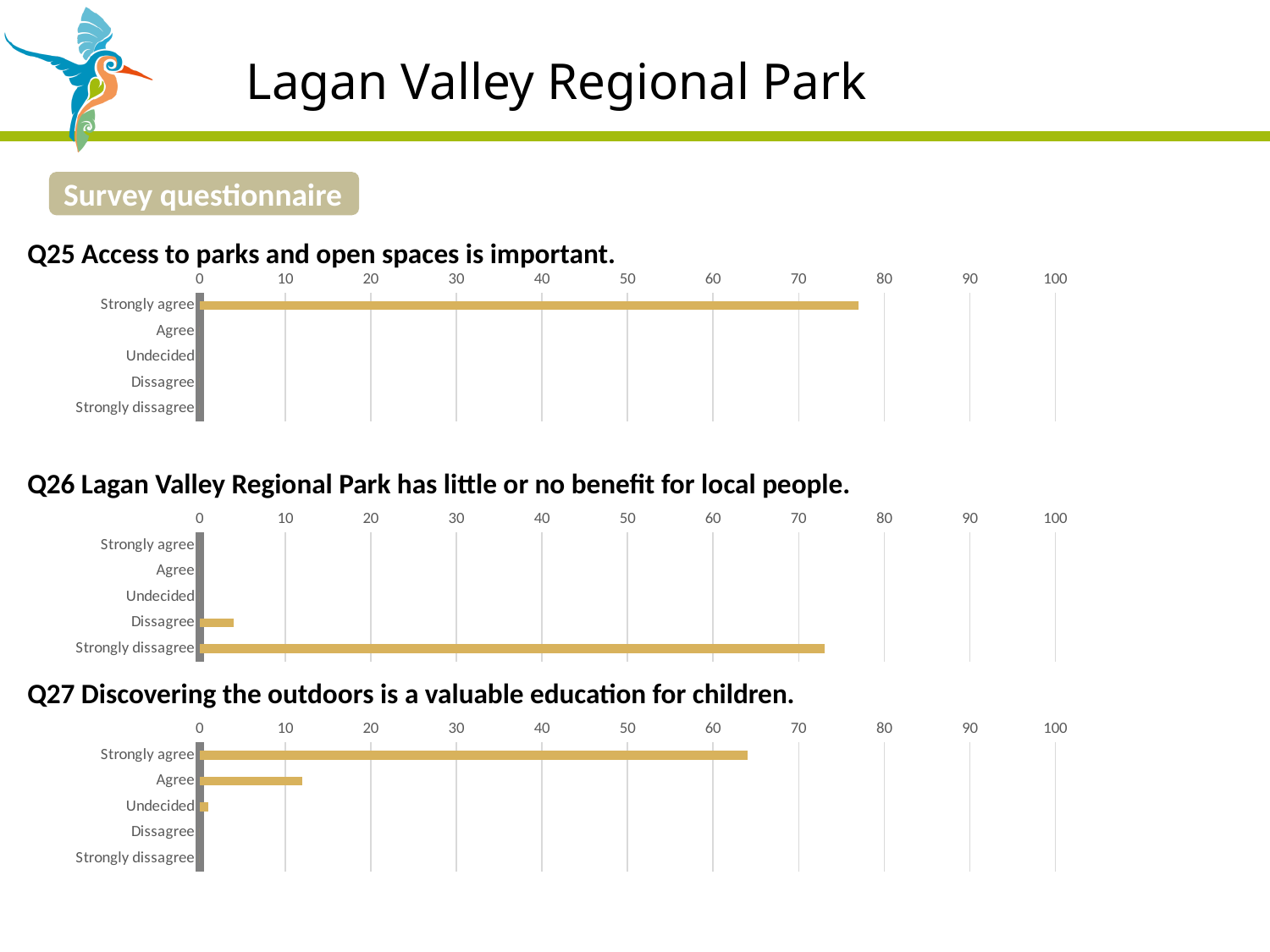
In the Q25 chart, which category has the highest value? Strongly agree In the Q25 chart, is the value for Strongly agree greater or less than 70? greater In the Q26 chart, is the value for Dissagree greater or less than 10? less In the Q27 chart, is the value for Strongly agree greater or less than 60? greater What kind of chart is used for Q25 Access to parks and open spaces is important? bar chart In the Q27 chart, which category has the highest value? Strongly agree In the Q26 chart, which is larger, Dissagree or Strongly dissagree? Strongly dissagree What is the title of the bottom chart on the slide? Q27 Discovering the outdoors is a valuable education for children. In the Q27 chart, which is larger, Agree or Undecided? Agree How many categories are shown on the Q25 chart? 5 In the Q26 chart, which category has the highest value? Strongly dissagree